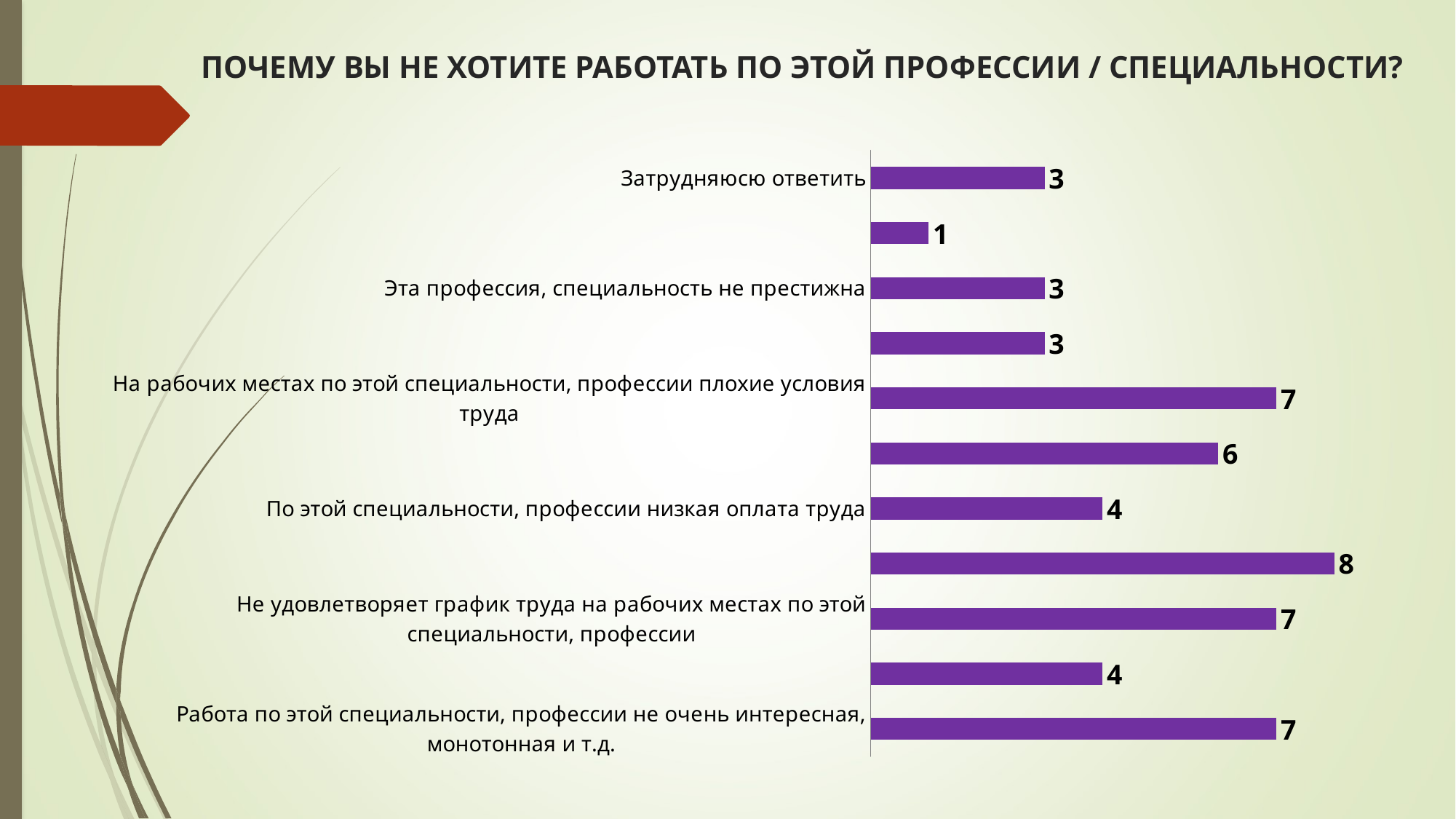
What is the difference between the values for "На рабочих местах по этой специальности, профессии плохие условия труда" and "По этой специальности, профессии низкая оплата труда"? 3 What is the value for "Работа по этой специальности, профессии не очень интересная, монотонная и т.д."? 7 What is the value for "Затрудняюсь ответить"? 3 What colour are the bars in the chart? Purple What is the value for "По этой специальности, профессии низкая оплата труда"? 4 How many bars are plotted in the chart? 11 What is the value for "Эта профессия, специальность не престижна"? 3 What is the value for "Не удовлетворяет график труда на рабочих местах по этой специальности, профессии"? 7 Which has the larger value: "По этой специальности, профессии низкая оплата труда" or "Эта профессия, специальность не престижна"? По этой специальности, профессии низкая оплата труда What is the value for "На рабочих местах по этой специальности, профессии плохие условия труда"? 7 What is the title of the slide? ПОЧЕМУ ВЫ НЕ ХОТИТЕ РАБОТАТЬ ПО ЭТОЙ ПРОФЕССИИ / СПЕЦИАЛЬНОСТИ? What kind of chart is shown on the slide? Bar chart